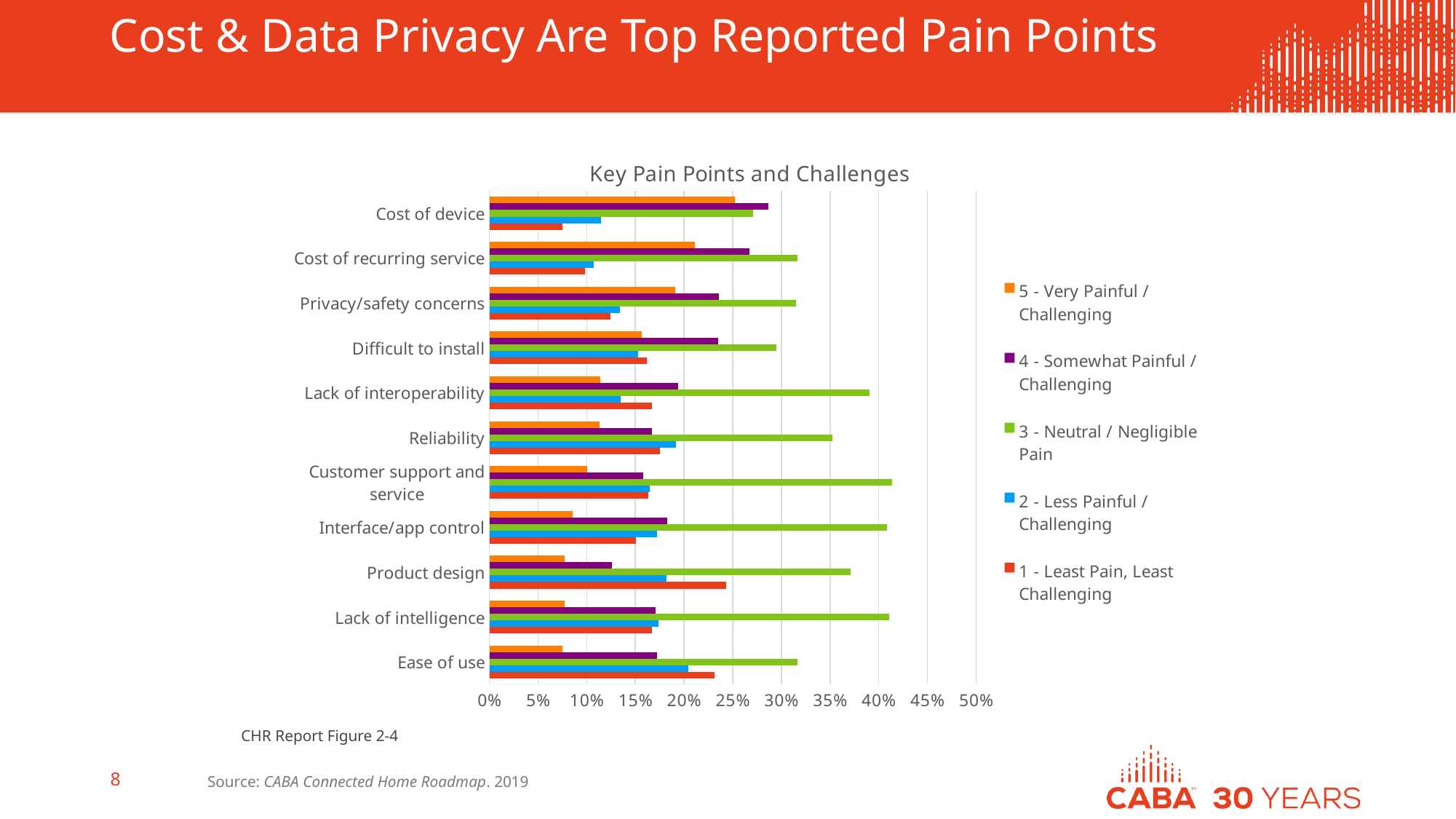
Is the "1 - Least Pain, Least Challenging" value for Product design greater or less than 20%? greater For Privacy/safety concerns, which is larger: the "3 - Neutral / Negligible Pain" value or the "5 - Very Painful / Challenging" value? 3 - Neutral / Negligible Pain Which colour represents the "3 - Neutral / Negligible Pain" series? Green What kind of chart is shown on the slide? Bar chart How many pain point categories are listed on the chart? 11 Is the "5 - Very Painful / Challenging" value for Ease of use greater or less than 10%? less Is the "5 - Very Painful / Challenging" value for Cost of device greater or less than 20%? greater How many series does the legend list? 5 What is the title of the chart? Key Pain Points and Challenges Which category has the highest value for "5 - Very Painful / Challenging"? Cost of device Which category has the lowest value for "1 - Least Pain, Least Challenging"? Cost of device